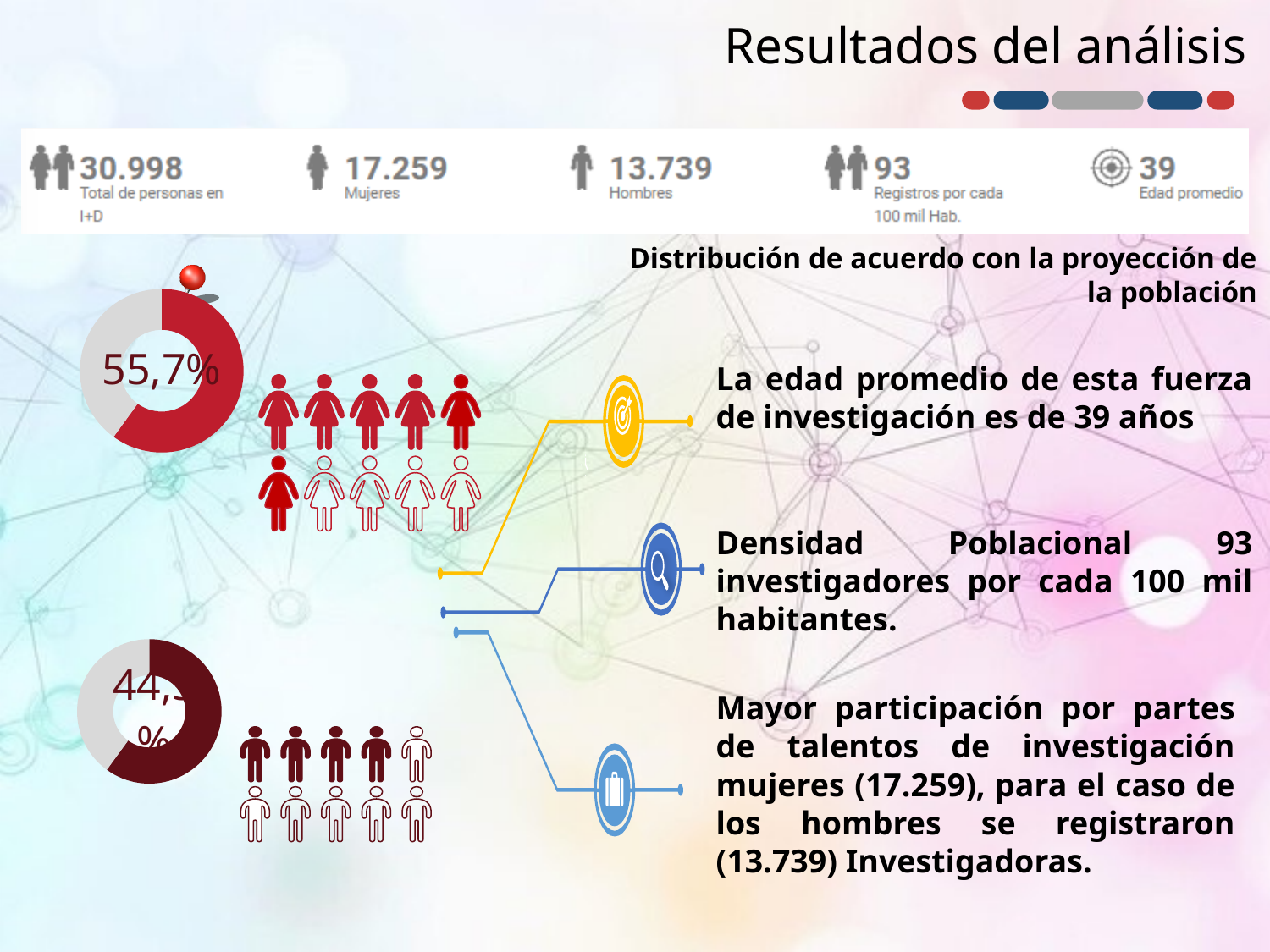
What colour is the non-highlighted segment in both donut charts? grey How many of the female person icons next to the top donut chart are filled in solid colour? 6 How many of the male person icons next to the bottom donut chart are filled in solid colour? 4 How many male person icons are shown in the pictogram next to the bottom donut chart? 10 What kind of chart is used to show the 55,7% value on the left of the slide? donut chart Is the highlighted share in the top donut chart greater or less than 50%? greater What percentage is printed inside the top donut chart on the left? 55,7% What colour is the highlighted segment of the top donut chart? red